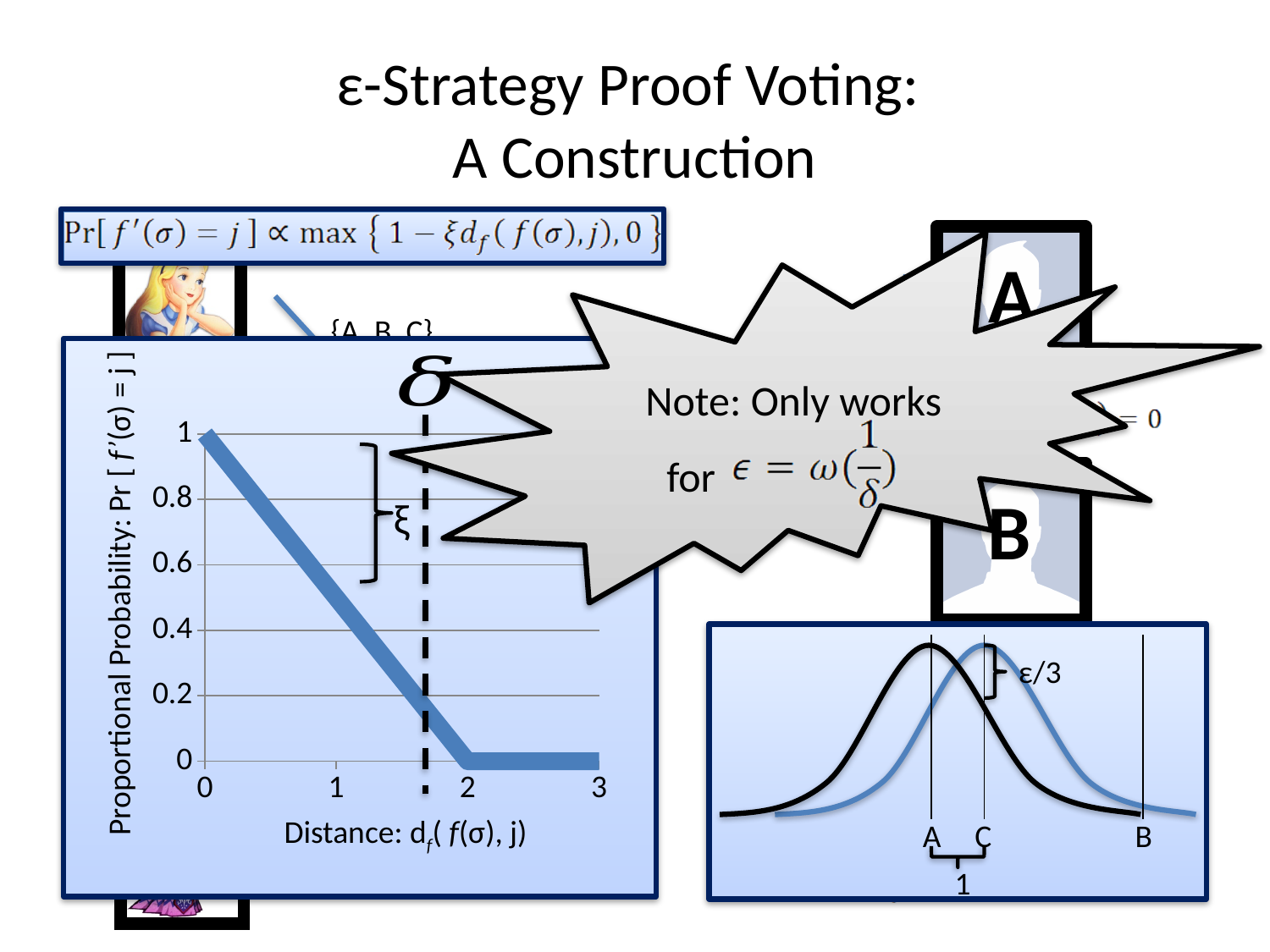
In the left chart, at which distance on the x axis is the proportional probability highest? 0 In the left chart, what is the largest distance value shown on the x axis? 3 In the left chart, what is the difference between the proportional probability at distance 0 and at distance 2? 1 In the left chart, does the proportional probability rise or fall as the distance increases from 0 to 2? falls In the left chart, which symbol labels the bracket drawn next to the line? ξ In the left chart, what is the proportional probability at distance 2? 0 What kind of chart is the chart on the left of the slide (Proportional Probability vs Distance)? line chart In the left chart, is the proportional probability at distance 1 greater or less than 0.4? greater In the left chart, what is the proportional probability at distance 3? 0 In the left chart, is the proportional probability at distance 1 greater or less than 0.6? less In the left chart, which is larger: the proportional probability at distance 0 or at distance 2? distance 0 In the left chart, what is the proportional probability at distance 0? 1